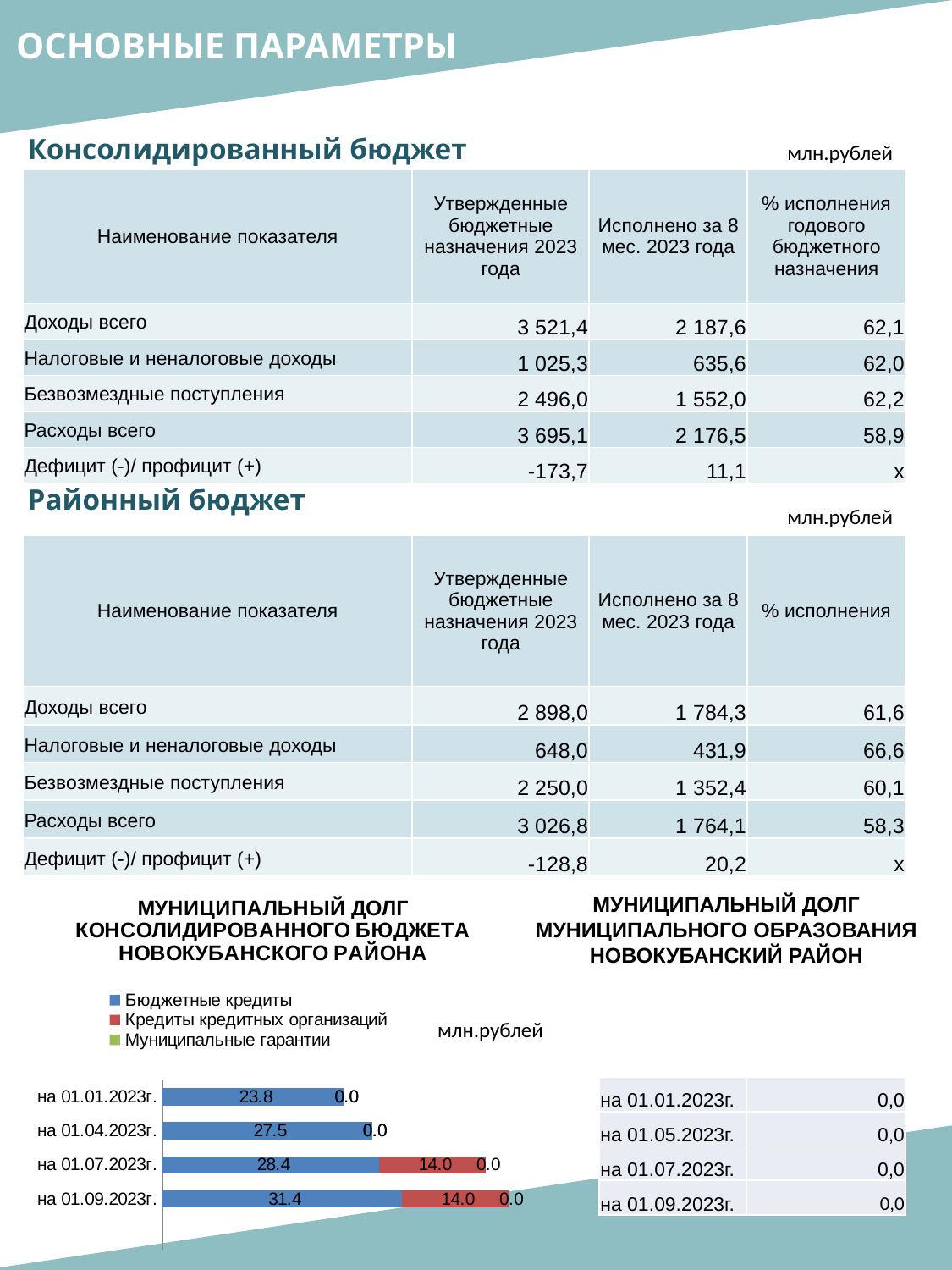
How many dates (categories) are shown on the chart? 4 What is the value of Бюджетные кредиты on 01.01.2023г.? 23.8 How many series does the legend of the chart list? 3 On which date is the value of Бюджетные кредиты the highest? на 01.09.2023г. Do the values of Бюджетные кредиты rise or fall from 01.01.2023г. to 01.09.2023г.? rise What is the total of the stacked bar for 01.09.2023г.? 45.4 On which date is the value of Бюджетные кредиты the lowest? на 01.01.2023г. What is the value of Муниципальные гарантии on 01.09.2023г.? 0.0 What is the value of Кредиты кредитных организаций on 01.07.2023г.? 14.0 What is the value of Бюджетные кредиты on 01.09.2023г.? 31.4 What is the difference between Бюджетные кредиты on 01.09.2023г. and on 01.01.2023г.? 7.6 What kind of chart is shown on the slide? bar chart